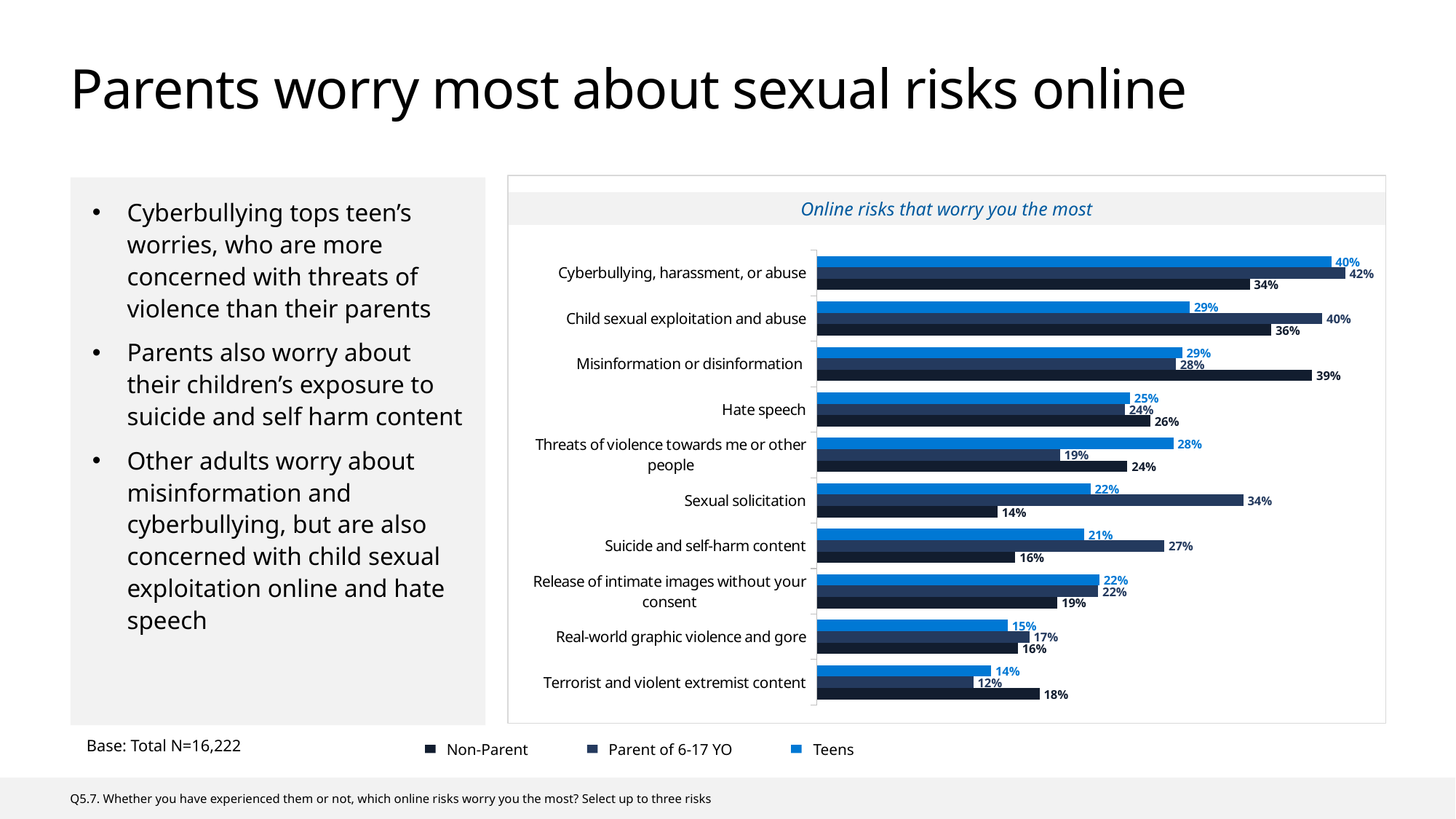
What percentage of Teens say cyberbullying, harassment, or abuse is an online risk that worries them the most? 40% How many online risk categories are shown in the chart? 10 Which online risk has the lowest Non-Parent value? Sexual solicitation How many series does the legend list? 3 What is the Parent of 6-17 YO value for suicide and self-harm content? 27% What type of chart is shown on the slide? Bar chart For threats of violence towards me or other people, which is larger: the Teens value or the Parent of 6-17 YO value? Teens What is the Parent of 6-17 YO value for sexual solicitation? 34% What is the difference between the Parent of 6-17 YO and Non-Parent values for sexual solicitation? 20% What is the Non-Parent value for misinformation or disinformation? 39% What is the title of the chart? Online risks that worry you the most Which online risk has the highest Parent of 6-17 YO value? Cyberbullying, harassment, or abuse